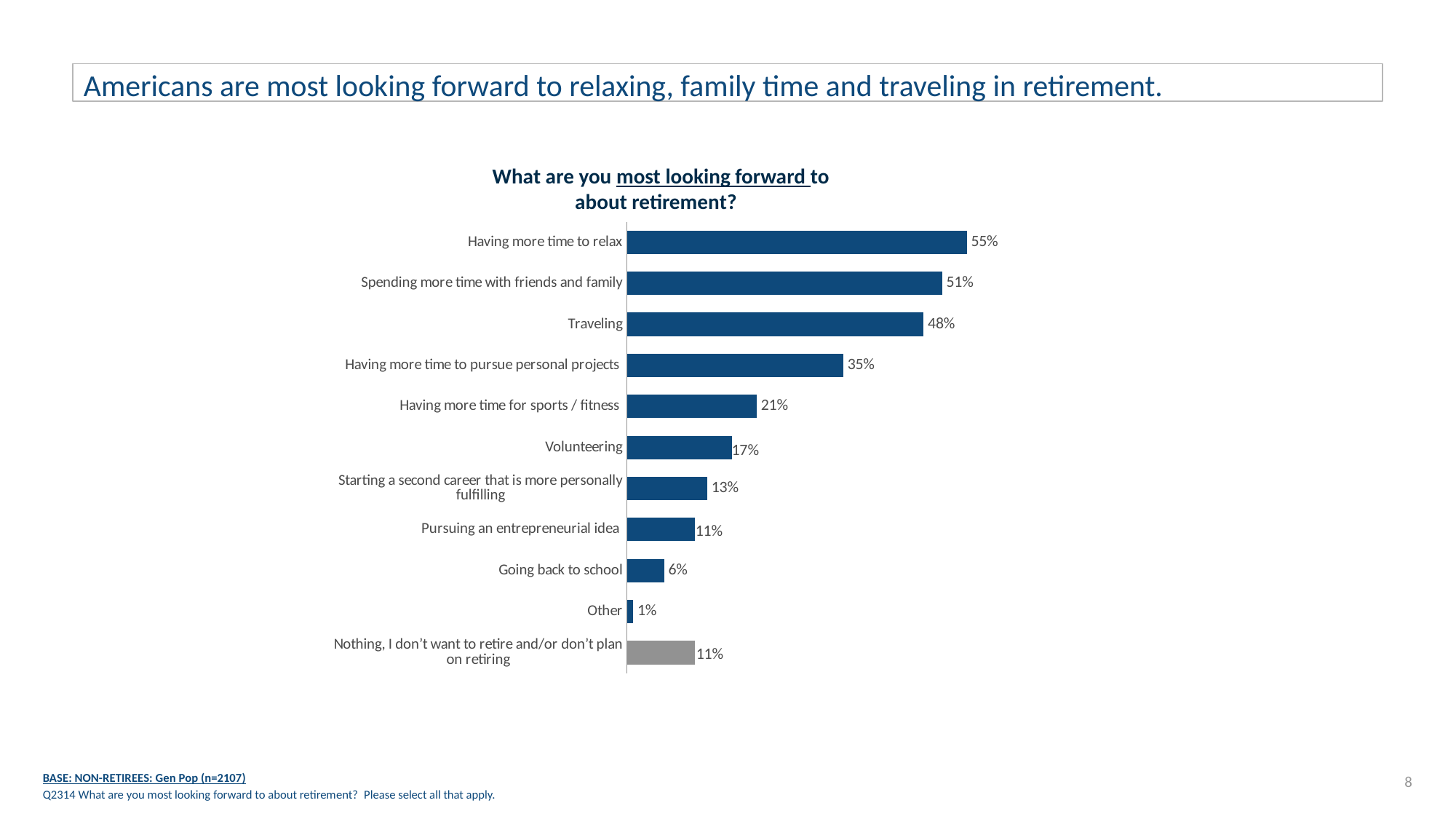
What is the value for Going back to school? 6% How many categories are shown in the chart? 11 What is the difference between Having more time to pursue personal projects and Having more time for sports / fitness? 14% What kind of chart is shown on the slide? Bar chart Which is larger: the value for Starting a second career that is more personally fulfilling or the value for Pursuing an entrepreneurial idea? Starting a second career that is more personally fulfilling Which category has the lowest value in the chart? Other What percentage selected Volunteering? 17% What is the difference between the values for Having more time to relax and Traveling? 7% Which category's bar is coloured grey instead of blue? Nothing, I don't want to retire and/or don't plan on retiring What is the value shown for Traveling? 48% What percentage of respondents are most looking forward to having more time to relax in retirement? 55% Which category has the highest value in the chart? Having more time to relax